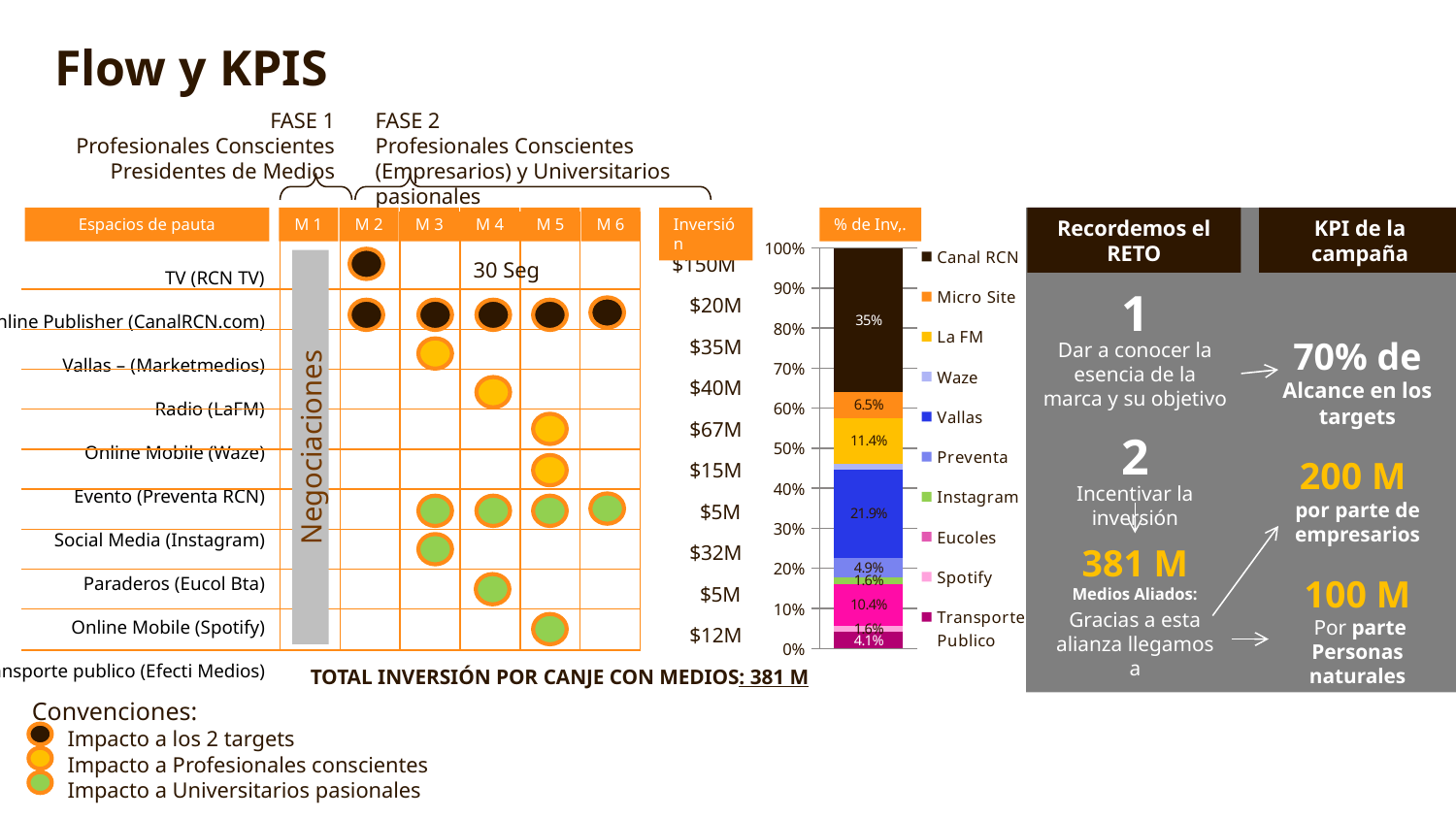
In the "% de Inv,." chart, what is the difference between the Canal RCN share (35%) and the Vallas share (21.9%)? 13.1% In the "% de Inv,." chart, what is the value labelled for Canal RCN? 35% In the "% de Inv,." chart, what is the value labelled for Vallas? 21.9% In the "% de Inv,." chart, what is the value labelled for La FM? 11.4% In the "% de Inv,." chart, which series has the largest share of the stacked bar? Canal RCN In the "% de Inv,." chart, what is the value labelled for Eucoles? 10.4% How many series does the legend of the "% de Inv,." chart list? 10 In the "% de Inv,." chart, what is the difference between the La FM share (11.4%) and the Micro Site share (6.5%)? 4.9% What is the title of the stacked bar chart on the slide? % de Inv,. In the "% de Inv,." chart, which is larger, the share for Canal RCN or the share for Vallas? Canal RCN What kind of chart is the "% de Inv,." chart? bar chart In the "% de Inv,." chart, what is the value labelled for Transporte Publico? 4.1%